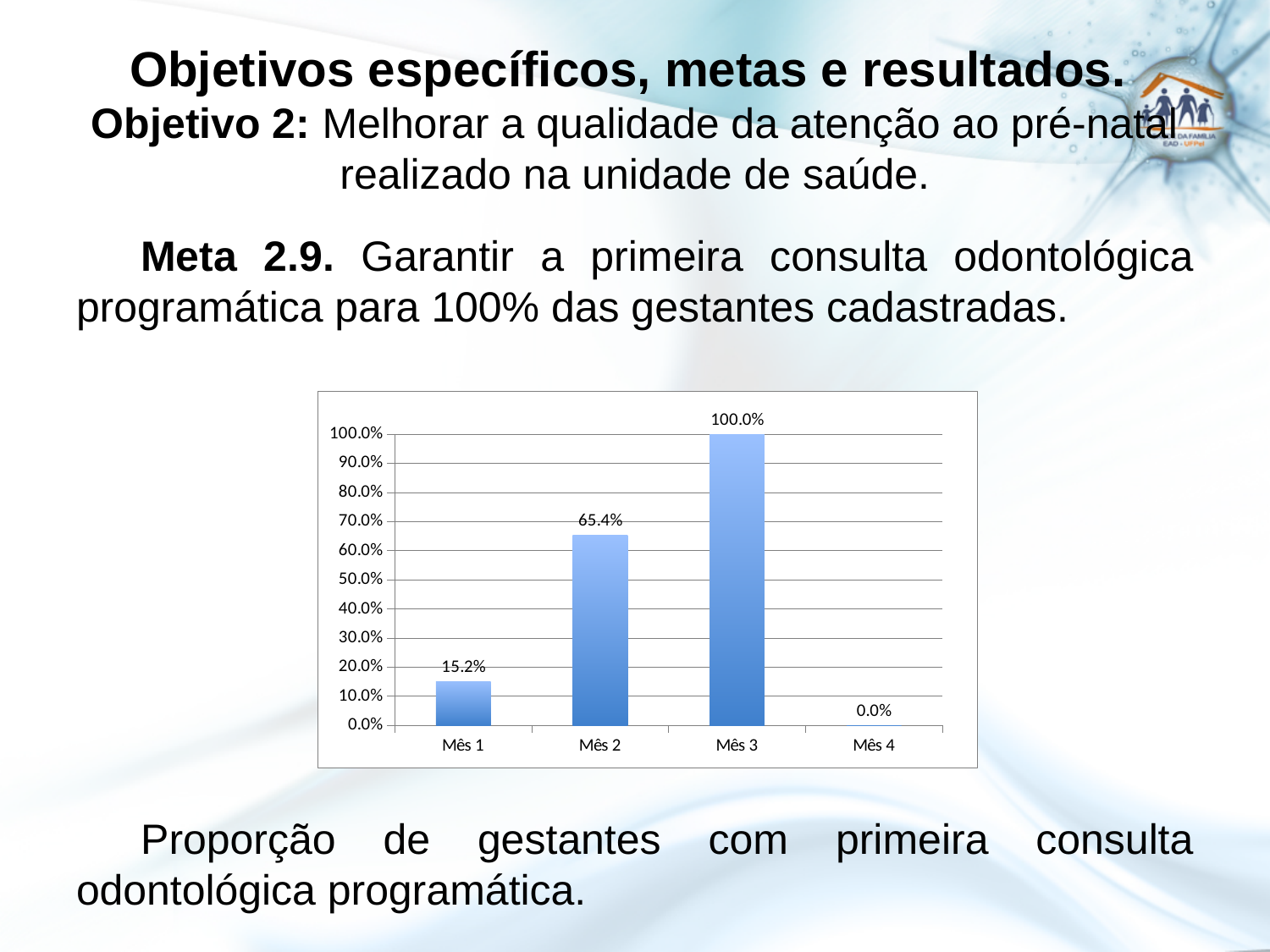
What is the value for Mês 1? 15.2% What is the value for Mês 3? 100.0% What kind of chart is shown on the slide? Bar chart Which is larger, the value for Mês 1 or the value for Mês 2? Mês 2 Do the values rise or fall from Mês 1 to Mês 3? Rise What is the difference between the values for Mês 3 and Mês 2? 34.6% How many months are shown on the x axis? 4 What is the difference between the values for Mês 2 and Mês 1? 50.2% Which month has the highest value? Mês 3 What is the value for Mês 4? 0.0% Which month has the lowest value? Mês 4 What is the value for Mês 2? 65.4%